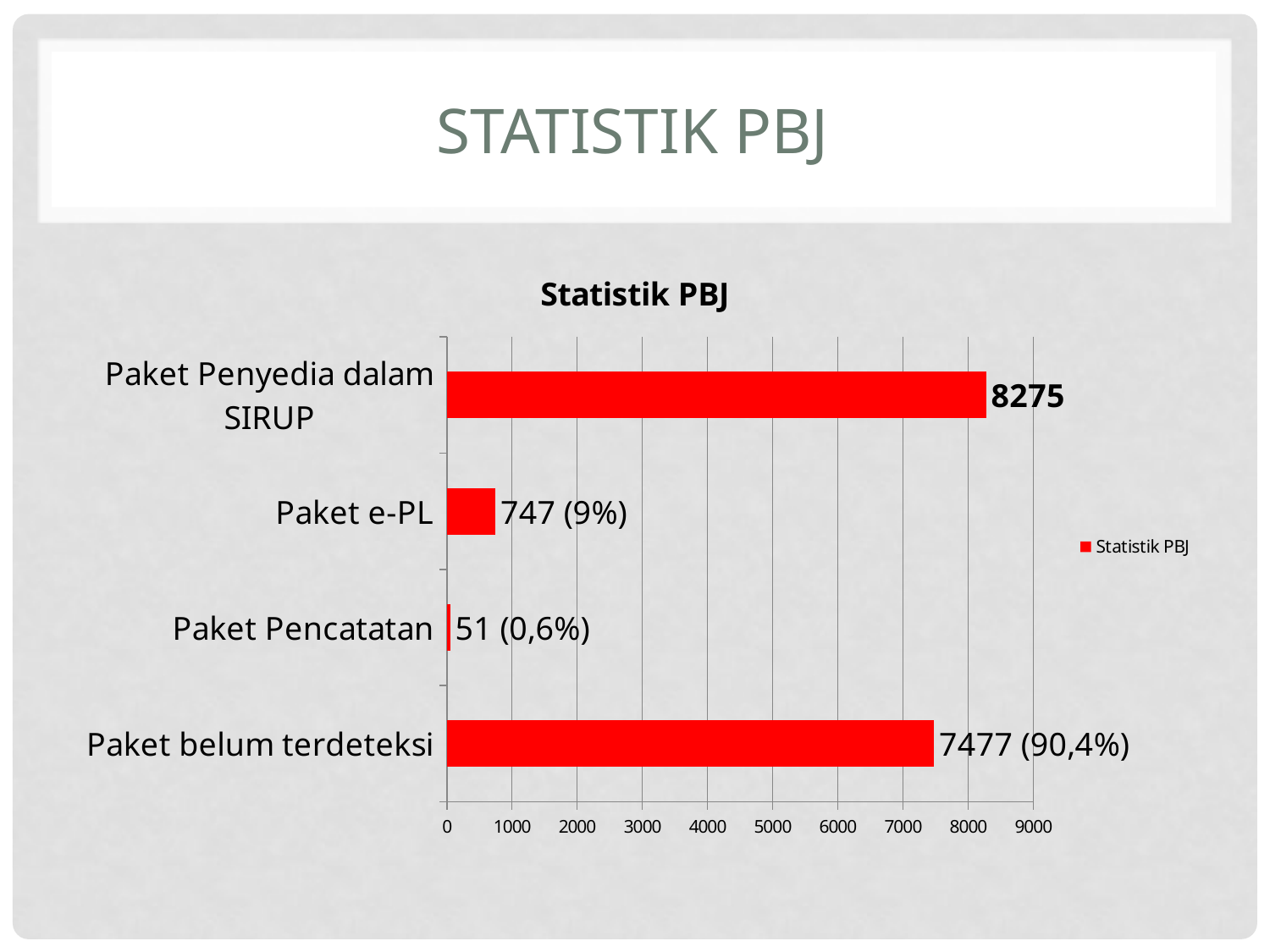
What is the data label shown for Paket Pencatatan? 51 (0,6%) What is the difference between the values for Paket Penyedia dalam SIRUP and Paket belum terdeteksi? 798 What kind of chart is shown on the slide? bar chart Which is larger, the value for Paket e-PL or the value for Paket Pencatatan? Paket e-PL How many categories are shown in the chart? 4 What is the title of the chart? Statistik PBJ What is the data label shown for Paket belum terdeteksi? 7477 (90,4%) Which category has the lowest value? Paket Pencatatan Which category has the highest value? Paket Penyedia dalam SIRUP What is the value for Paket Penyedia dalam SIRUP? 8275 Is the value for Paket belum terdeteksi greater or less than 7000? greater What is the data label shown for Paket e-PL? 747 (9%)